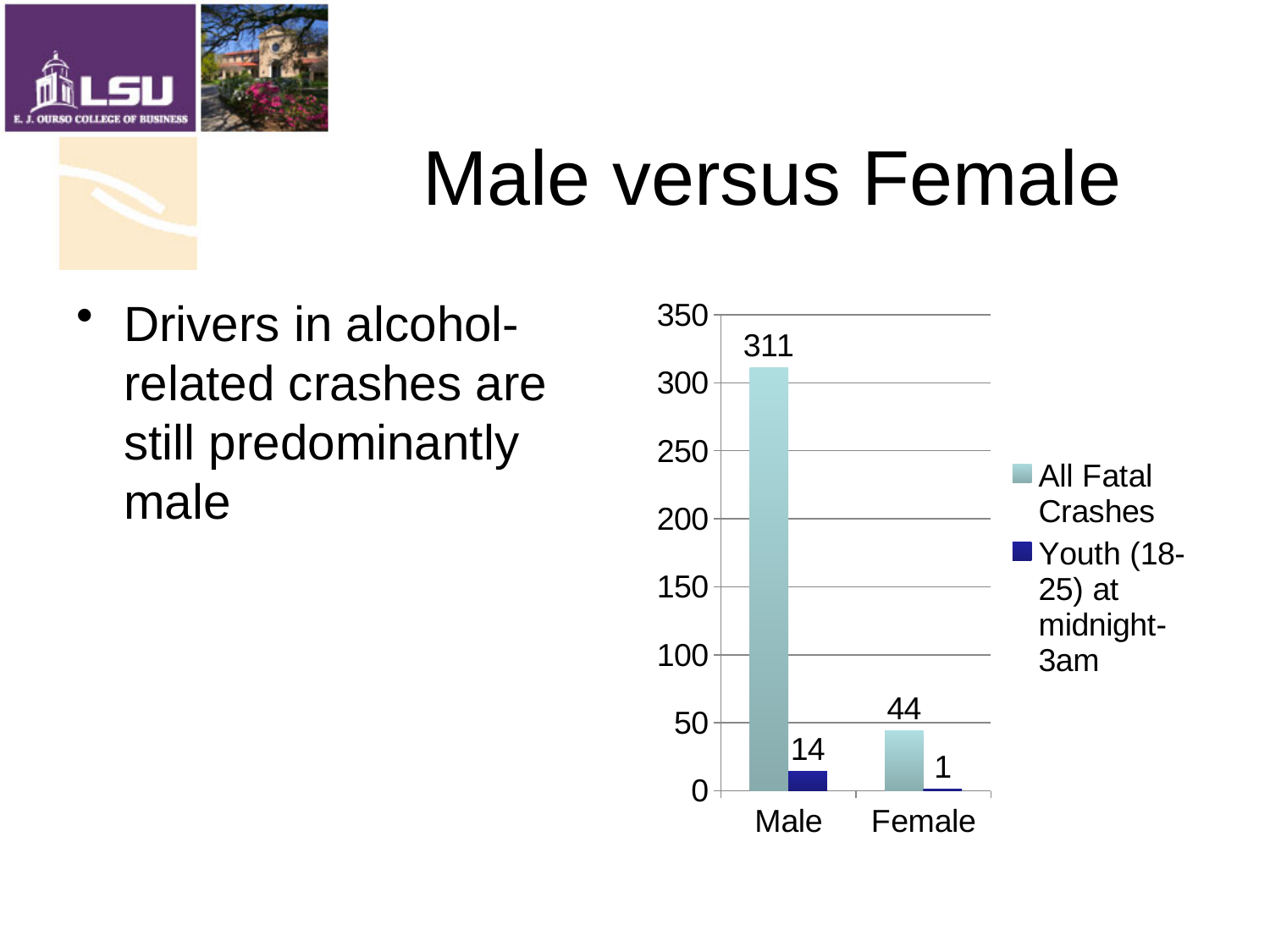
What is the difference between the Male and Female values for All Fatal Crashes? 267 What is the value for Female in the Youth (18-25) at midnight-3am series? 1 Which is larger: the Male value for Youth (18-25) at midnight-3am or the Female value for All Fatal Crashes? Female value for All Fatal Crashes What is the difference between the Male and Female values for Youth (18-25) at midnight-3am? 13 What is the value for Male in the All Fatal Crashes series? 311 What is the value for Male in the Youth (18-25) at midnight-3am series? 14 Which category has the highest value for All Fatal Crashes? Male What kind of chart is shown on the slide? Bar chart How many series does the legend list? 2 Which category has the lowest value for Youth (18-25) at midnight-3am? Female What is the value for Female in the All Fatal Crashes series? 44 How many categories are shown on the x axis? 2